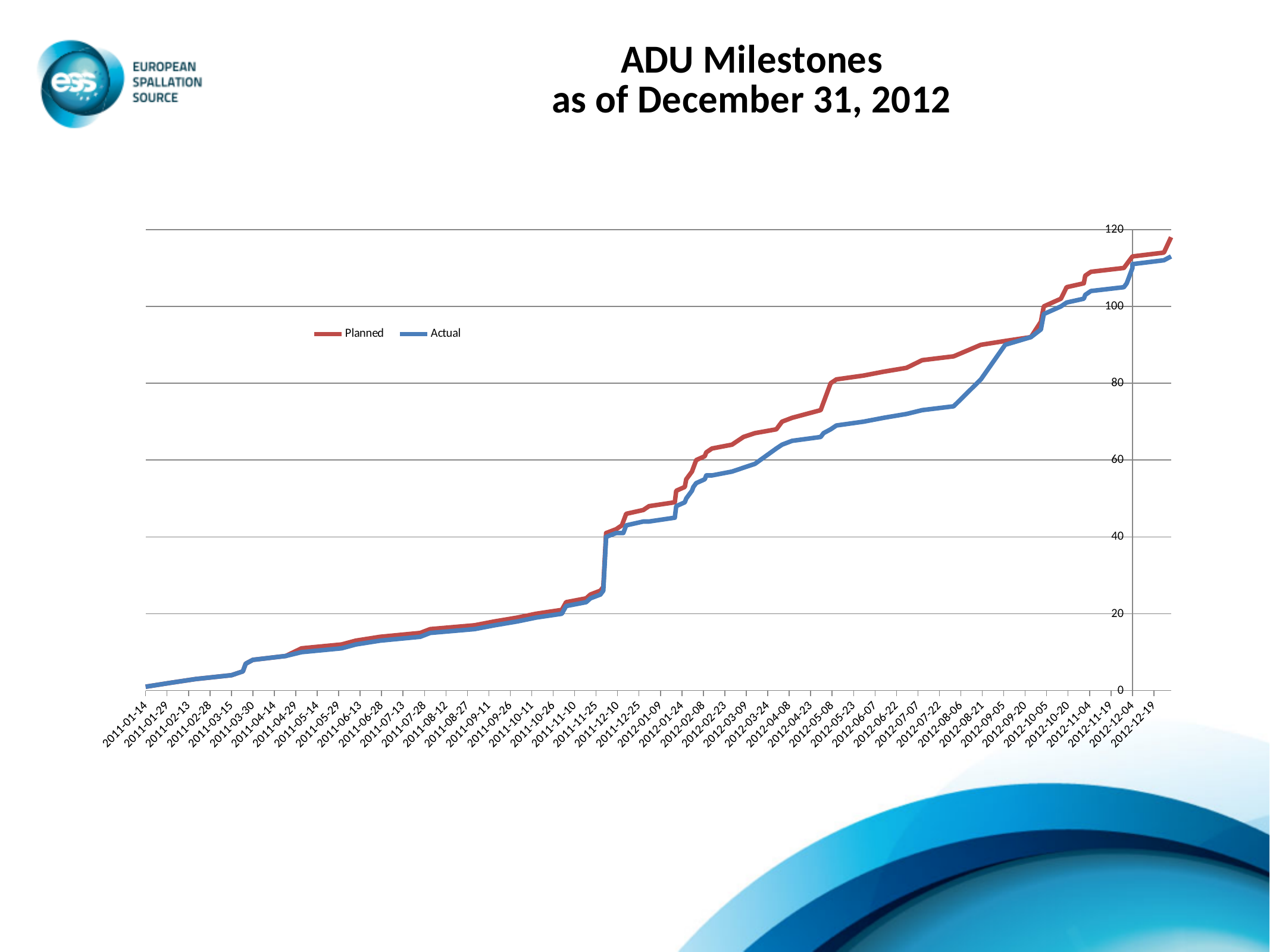
Is the Actual value at 2012-08-06 greater or less than 80? less Which colour is used for the Actual series? blue Do the Actual values rise or fall over the period shown? rise Is the Planned value at 2012-12-19 greater or less than 100? greater Do the Planned values rise or fall along the x axis from 2011-01-14 to 2012-12-19? rise What are the names of the two series in the legend? Planned and Actual How many series does the legend list? 2 Is the Actual value at 2012-05-08 greater or less than 60? greater At 2012-08-06, which series has the larger value, Planned or Actual? Planned At 2012-05-08, which series has the larger value, Planned or Actual? Planned What kind of chart is shown on the slide? line chart